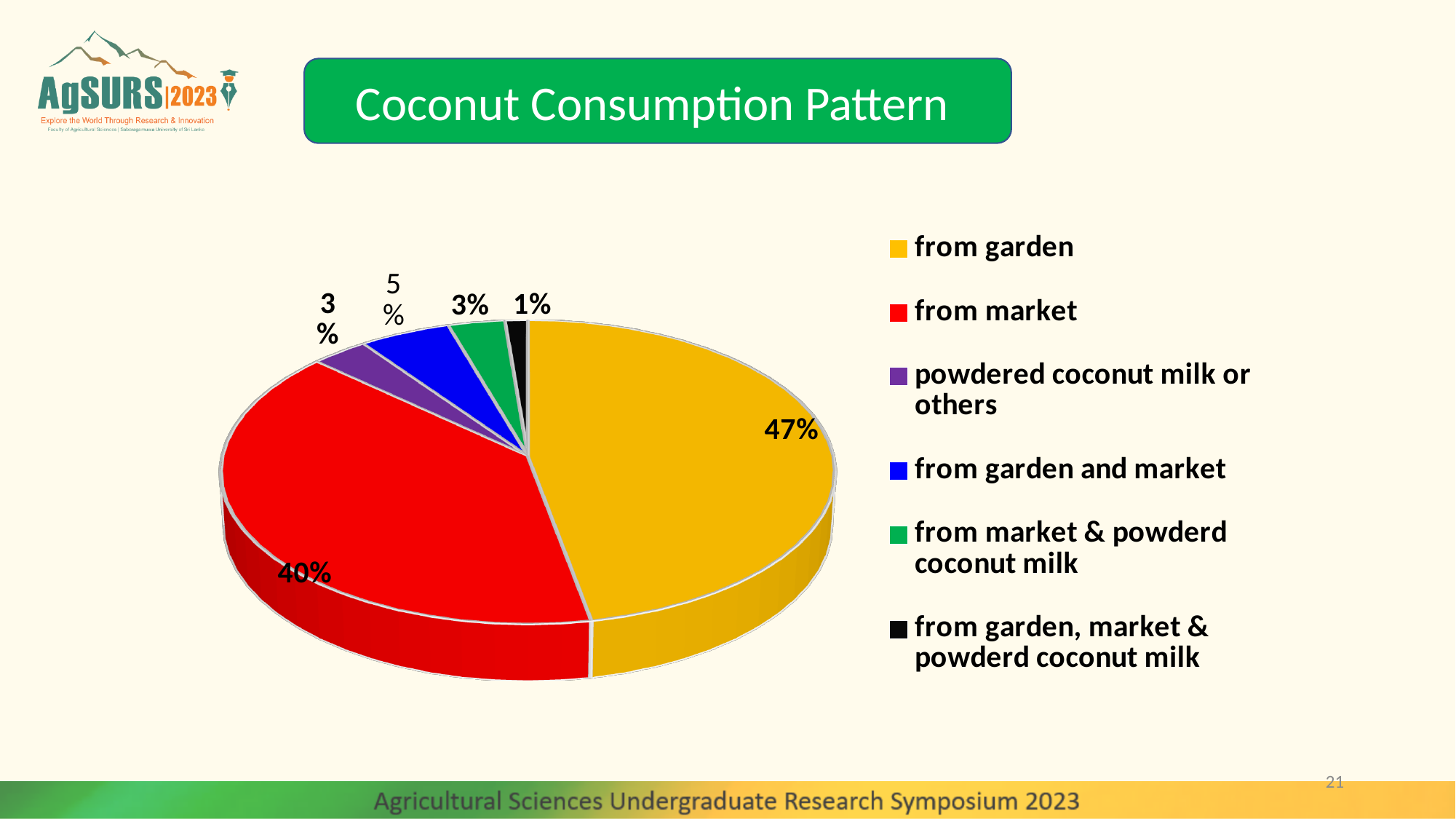
What share of the pie does 'from garden and market' represent? 5% Which category has the largest share of the pie? from garden What share of the pie does 'from garden, market & powderd coconut milk' represent? 1% What colour represents 'from market' in the pie chart? red How many categories does the legend list? 6 Which category has the smallest share of the pie? from garden, market & powderd coconut milk Which is larger, the share for 'from garden and market' or the share for 'from market & powderd coconut milk'? from garden and market What type of chart is shown on the slide? pie chart What is the title of the chart? Coconut Consumption Pattern What share of the pie does 'from garden' represent? 47% What is the difference in percentage points between 'from garden' and 'from market'? 7 What share of the pie does 'from market' represent? 40%